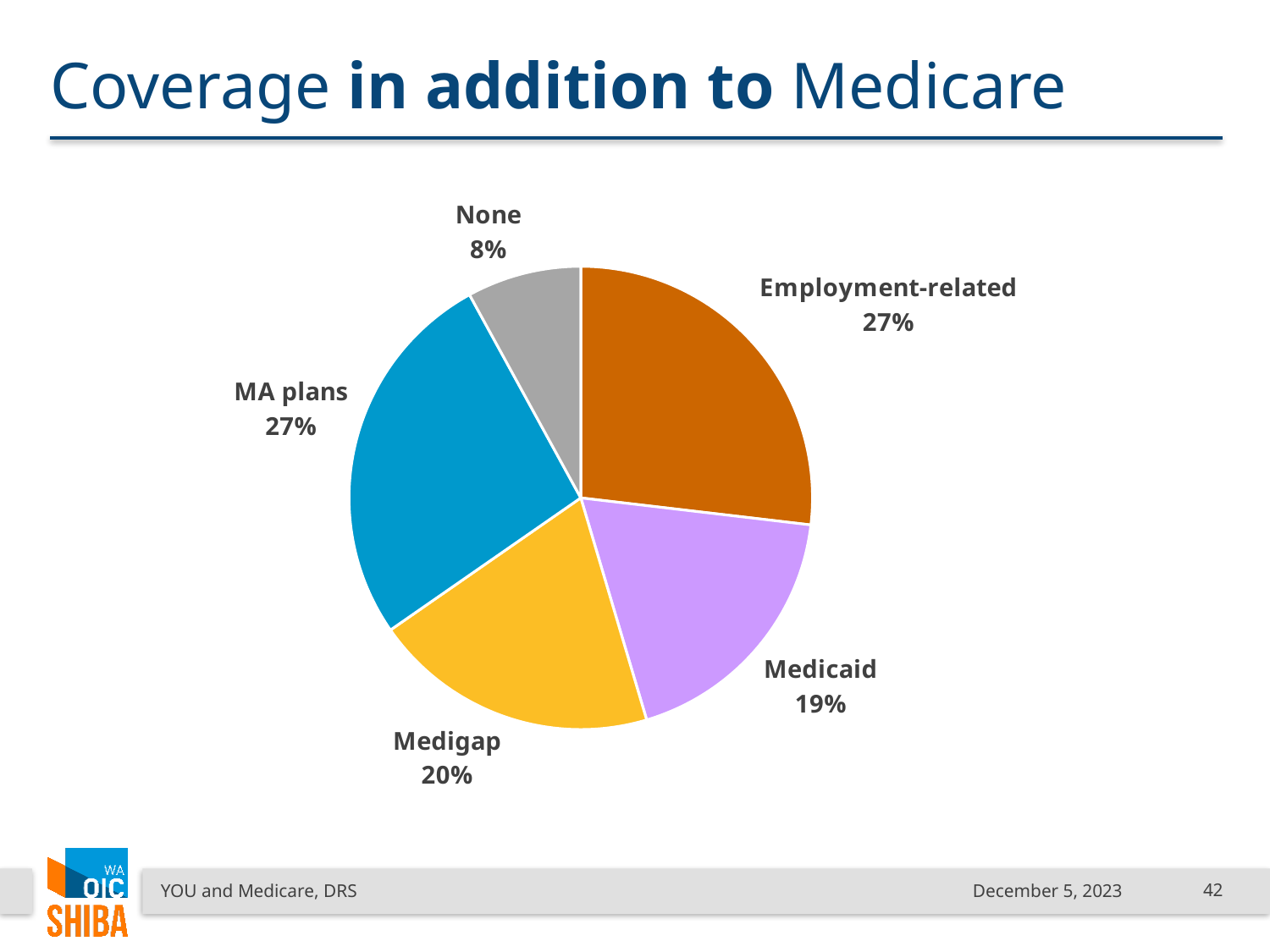
What is the title of the slide containing the pie chart? Coverage in addition to Medicare What is the difference in percentage points between MA plans and Medicaid? 8 What percentage is shown for Medigap? 20% What percentage is shown for Employment-related coverage? 27% Which is larger, the Employment-related slice or the Medicaid slice? Employment-related What is the difference in percentage points between Medigap and None? 12 Which slice of the pie is the smallest? None What percentage of the pie is labelled None? 8% How many slices does the pie chart have? 5 What percentage is shown for MA plans? 27% What kind of chart is shown on the slide? pie chart What share of the pie is Medicaid? 19%